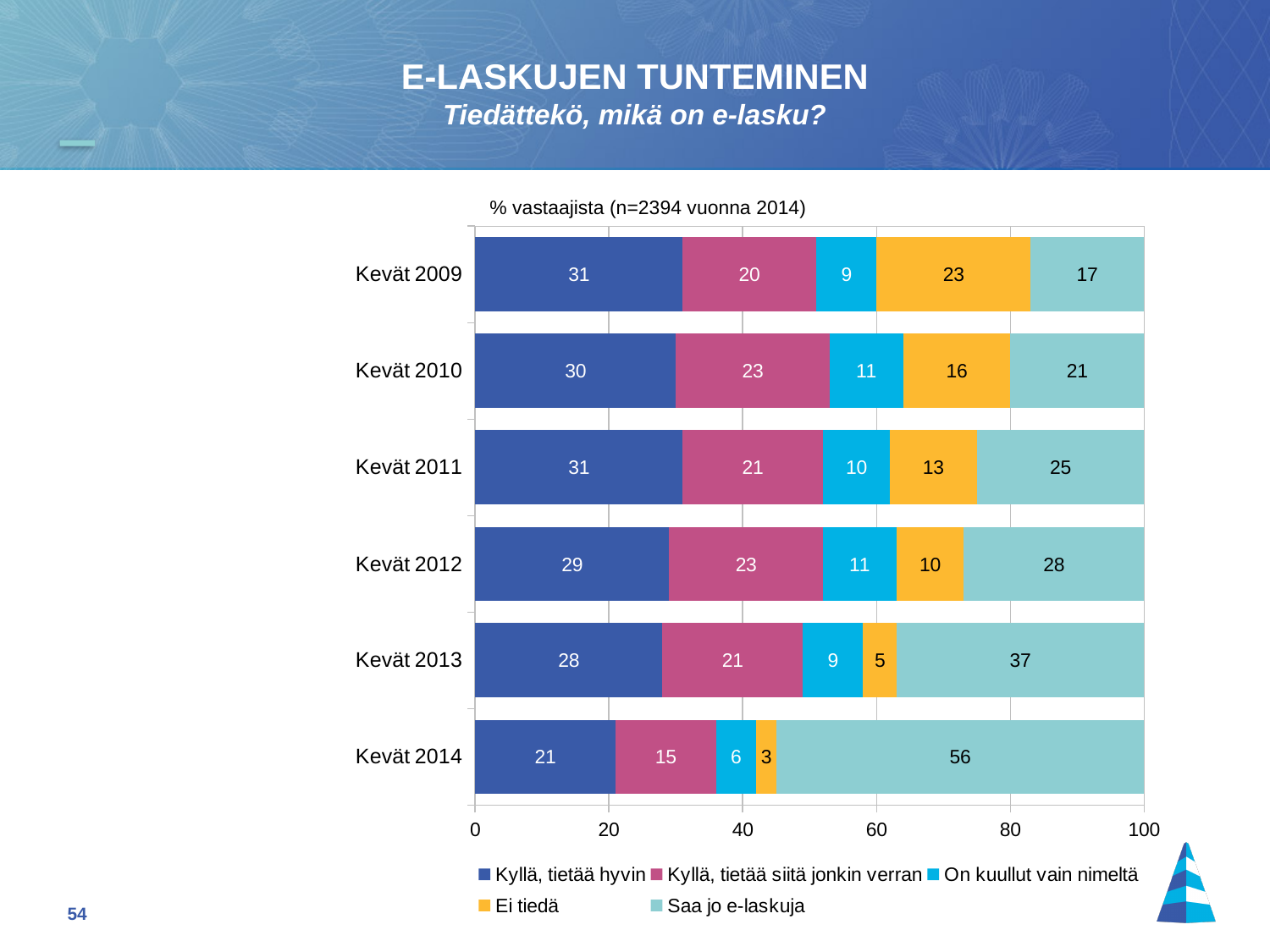
What kind of chart is shown on the slide? Stacked bar chart What is the value for "Saa jo e-laskuja" in Kevät 2014? 56 What is the value for "Kyllä, tietää hyvin" in Kevät 2009? 31 Which is larger: "Kyllä, tietää siitä jonkin verran" in Kevät 2010 or in Kevät 2014? Kevät 2010 What is the total of the stacked bar for Kevät 2012? 101 How many years (categories) are shown in the chart? 6 What is the difference between the "Saa jo e-laskuja" values for Kevät 2014 and Kevät 2013? 19 Which year has the highest value for "Saa jo e-laskuja"? Kevät 2014 What is the value for "Ei tiedä" in Kevät 2013? 5 Which year has the lowest value for "Ei tiedä"? Kevät 2014 How many series does the legend list? 5 Does the value for "Ei tiedä" rise or fall from Kevät 2009 to Kevät 2014? Fall